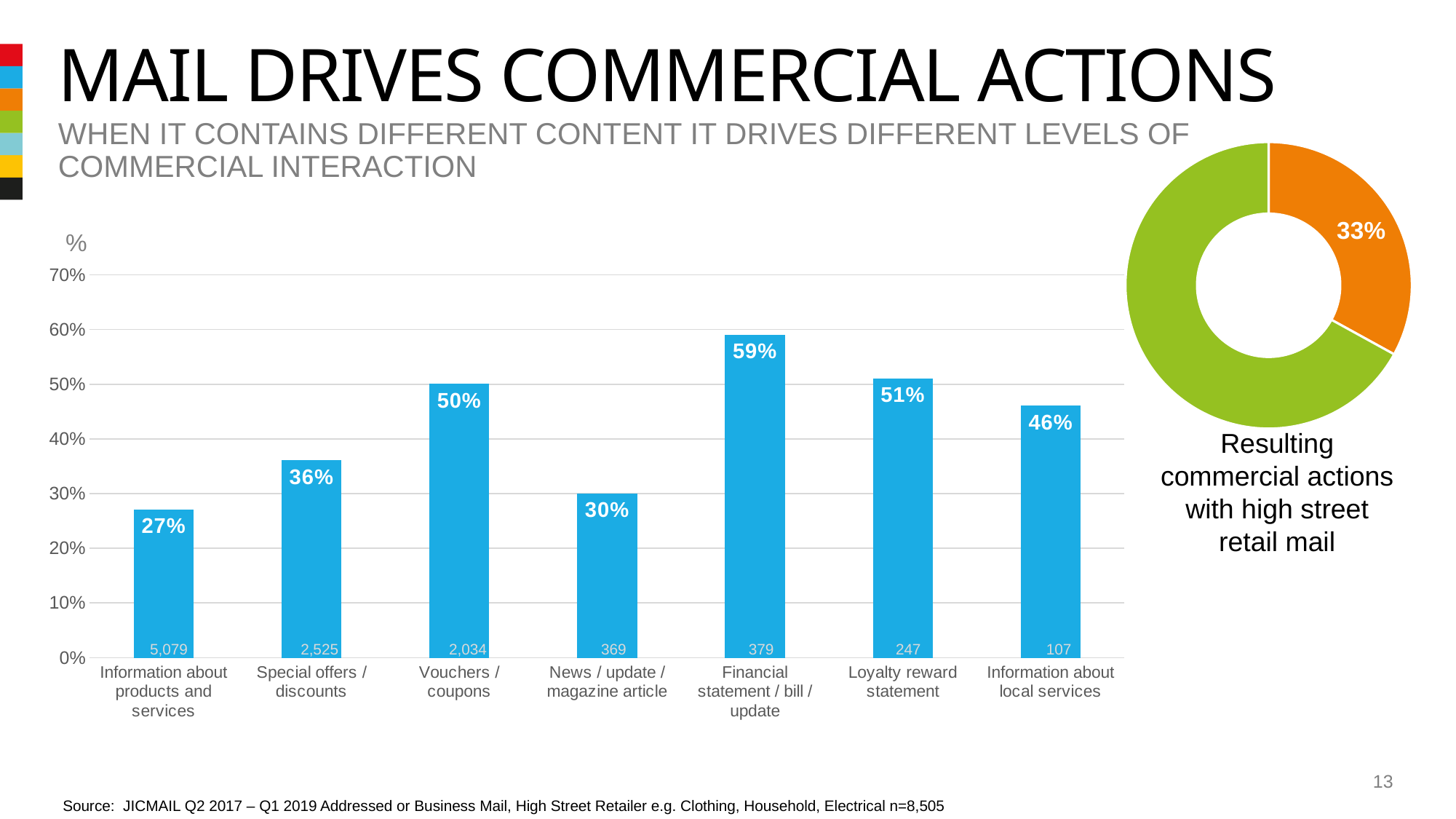
What kind of chart is the chart on the left of the slide? Bar chart In the bar chart, how many categories are shown? 7 In the bar chart, what is the difference between the values for Vouchers / coupons and News / update / magazine article? 20% In the doughnut chart on the right, what share is labelled on the orange segment? 33% In the bar chart, which category has the highest value? Financial statement / bill / update In the bar chart, which is larger: the value for Loyalty reward statement or the value for Information about local services? Loyalty reward statement In the bar chart, which category has the lowest value? Information about products and services What is the caption below the doughnut chart on the right? Resulting commercial actions with high street retail mail In the bar chart, what is the value for Financial statement / bill / update? 59% In the bar chart, what is the value for Special offers / discounts? 36% In the bar chart, what is the value for Information about local services? 46% In the bar chart, what is the sample size shown at the base of the Vouchers / coupons bar? 2,034